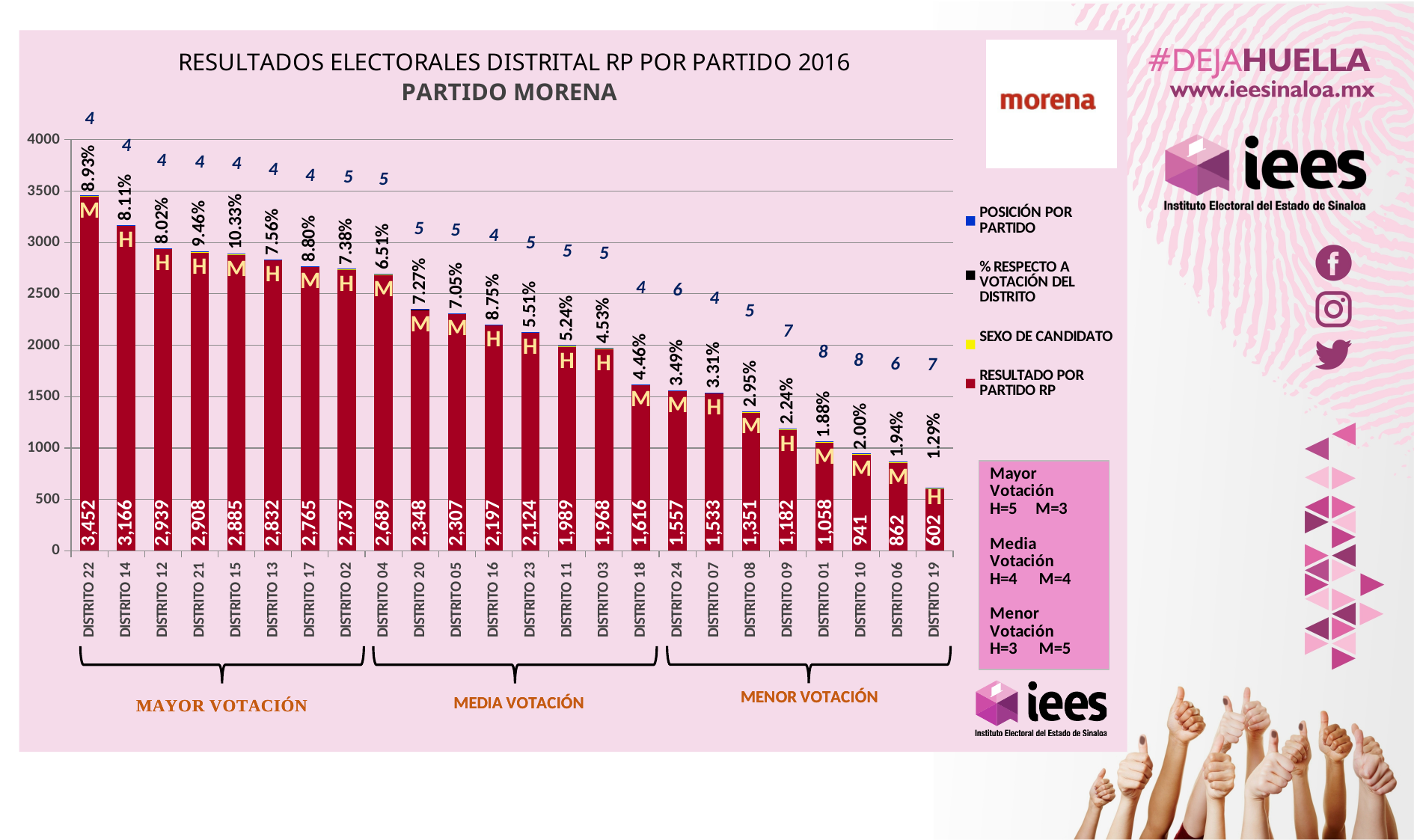
What is the difference between the RESULTADO POR PARTIDO RP values of DISTRITO 22 and DISTRITO 14? 286 What is the RESULTADO POR PARTIDO RP value for DISTRITO 22? 3,452 What type of chart is shown on the slide? Bar chart How many entries does the chart legend list? 4 Which has a larger RESULTADO POR PARTIDO RP value, DISTRITO 04 or DISTRITO 20? DISTRITO 04 Do the RESULTADO POR PARTIDO RP values rise or fall from left to right along the x axis? Fall What is the POSICIÓN POR PARTIDO number shown above the bar for DISTRITO 01? 8 How many districts are shown on the x axis of the chart? 24 What percentage (% RESPECTO A VOTACIÓN DEL DISTRITO) is shown for DISTRITO 15? 10.33% What is the RESULTADO POR PARTIDO RP value for DISTRITO 19? 602 Which district has the lowest RESULTADO POR PARTIDO RP value? DISTRITO 19 Which district has the highest RESULTADO POR PARTIDO RP value? DISTRITO 22